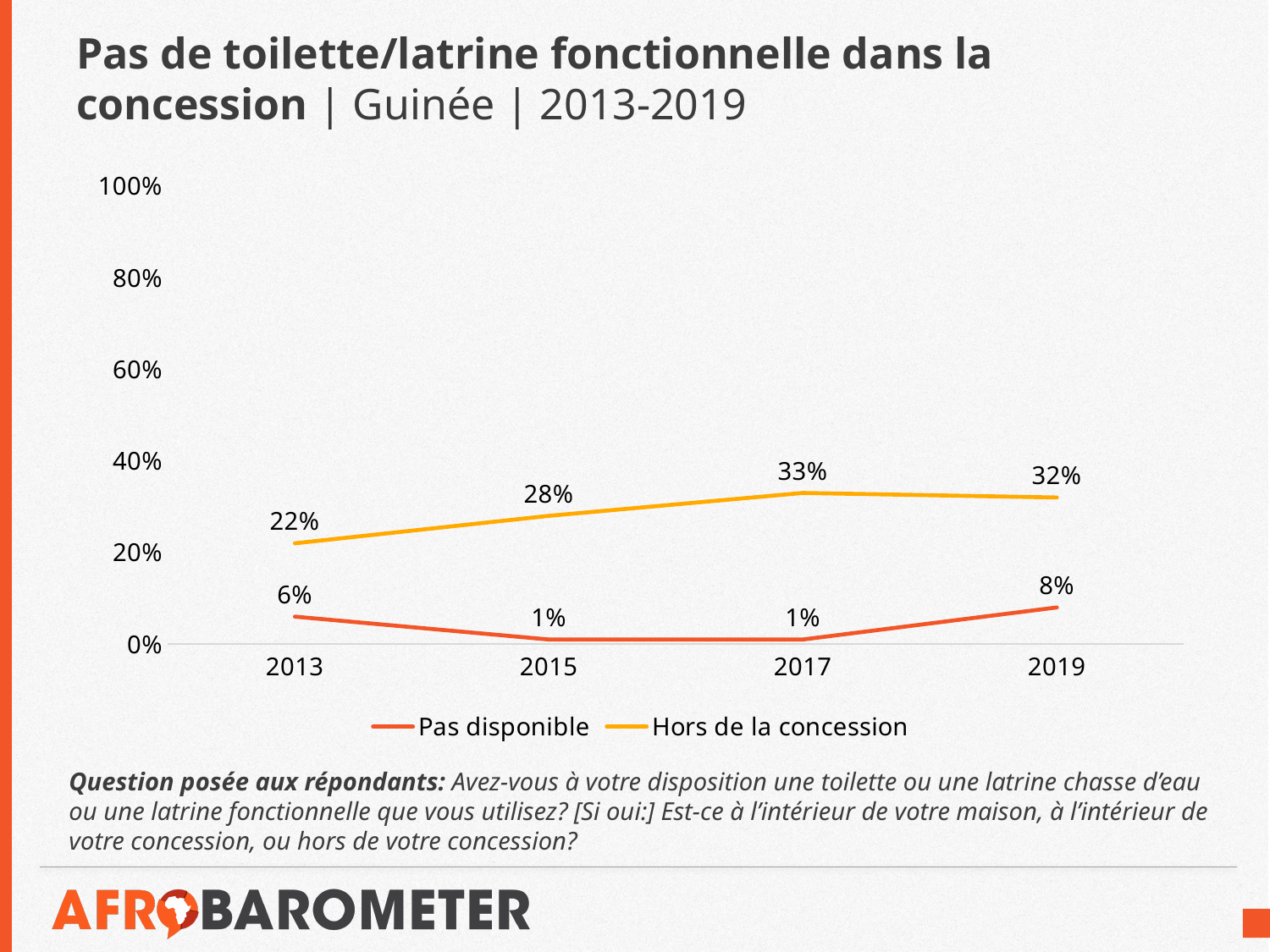
What is the value for "Pas disponible" in 2013? 6% How many years are plotted on the x axis? 4 What kind of chart is shown on the slide? line chart Does the "Hors de la concession" line rise or fall from 2013 to 2017? rise In which year is the value for "Hors de la concession" highest? 2017 What is the difference between "Hors de la concession" and "Pas disponible" in 2019? 24 percentage points What is the value for "Hors de la concession" in 2019? 32% Which series has the larger value in 2015, "Pas disponible" or "Hors de la concession"? Hors de la concession What is the value for "Hors de la concession" in 2017? 33% How many series does the legend list? 2 What is the difference between the "Hors de la concession" values in 2013 and 2017? 11 percentage points In which year is the value for "Pas disponible" highest? 2019